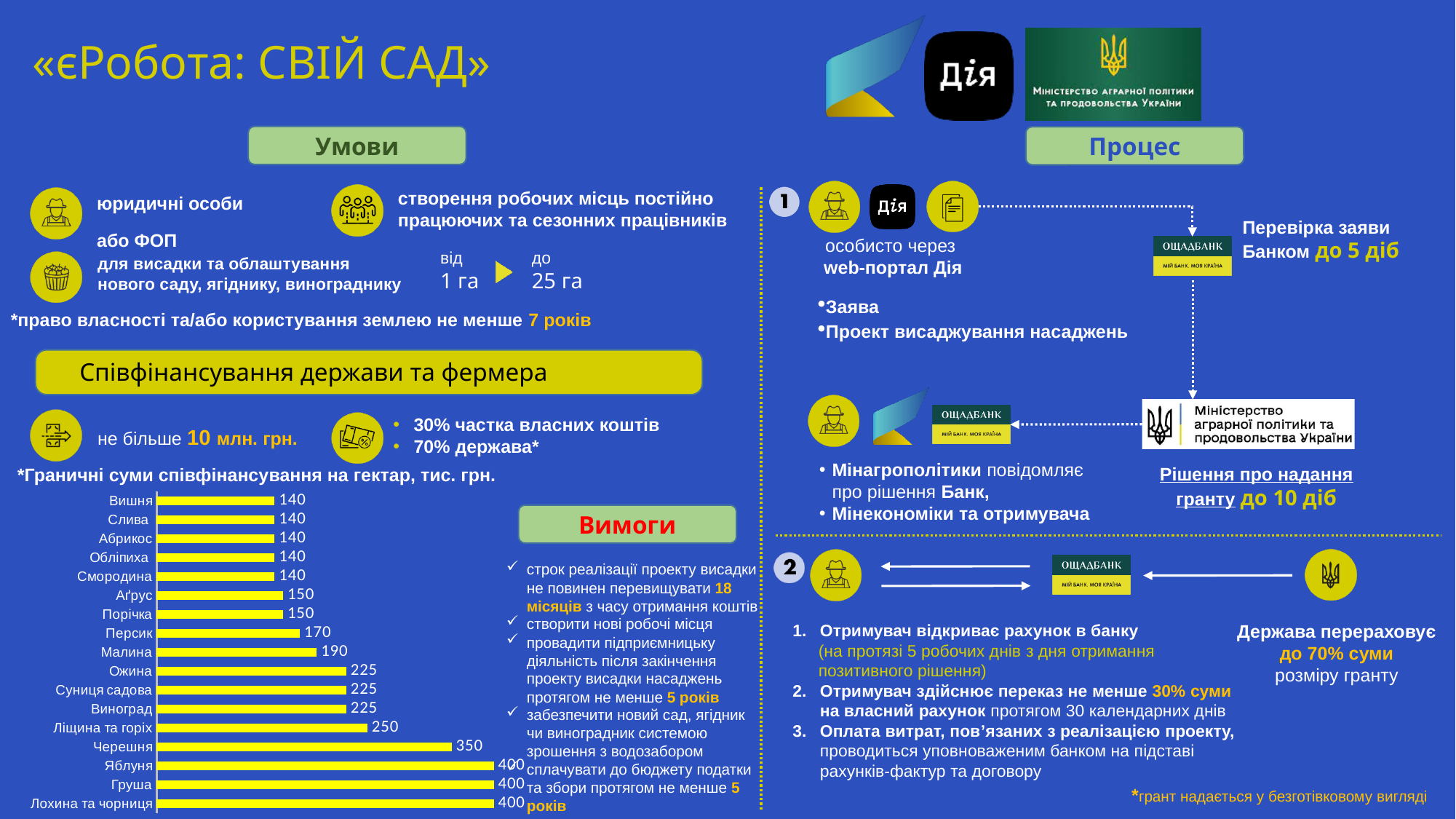
What is the difference between the values for Яблуня and Черешня in the bar chart? 50 What is the title of the bar chart on the slide? Граничні суми співфінансування на гектар, тис. грн. What is the value for Малина in the bar chart? 190 How many categories are shown in the bar chart? 17 What is the value for Черешня in the bar chart? 350 What type of chart is shown on the slide? Bar chart What is the lowest value shown in the bar chart? 140 Which has a larger value in the bar chart, Виноград or Малина? Виноград What is the difference between the values for Ожина and Аґрус in the bar chart? 75 What is the value for Персик in the bar chart? 170 What is the highest value shown in the bar chart? 400 What is the value for Ліщина та горіх in the bar chart? 250